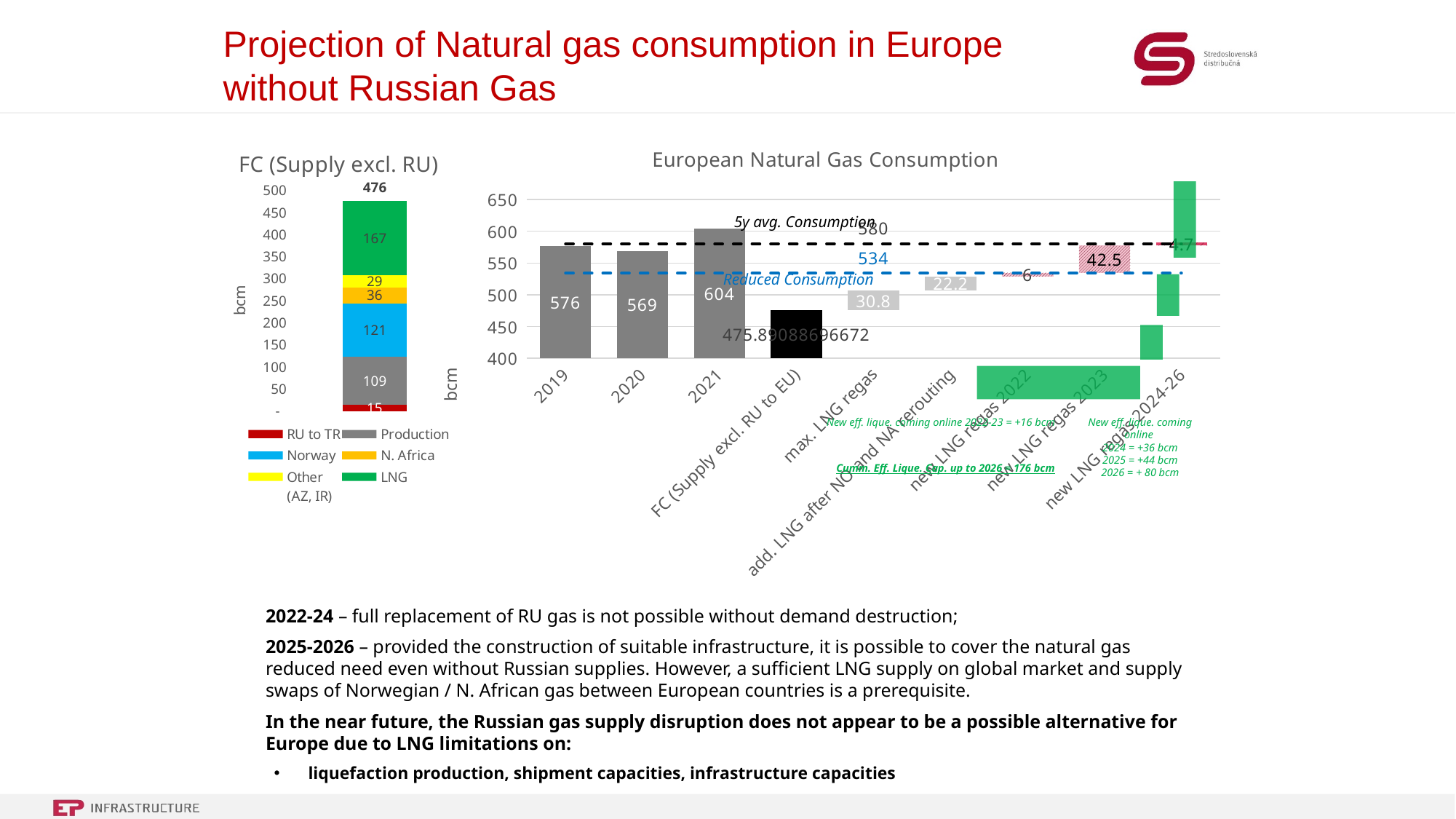
In the FC (Supply excl. RU) chart, which segment is the smallest? RU to TR In the European Natural Gas Consumption chart, which of the years 2019, 2020 and 2021 has the highest value? 2021 What kind of chart is the European Natural Gas Consumption chart? combination bar and line chart In the European Natural Gas Consumption chart, what is the value for max. LNG regas? 30.8 In the European Natural Gas Consumption chart, what is the value for 2021? 604 In the FC (Supply excl. RU) chart, what is the value of the Norway segment? 121 In the European Natural Gas Consumption chart, what value is shown for the 5y avg. Consumption line? 580 In the European Natural Gas Consumption chart, what is the difference between the 2019 and 2020 values? 7 In the FC (Supply excl. RU) chart, which segment is the largest? LNG In the FC (Supply excl. RU) chart, what is the value of the LNG segment? 167 How many series does the legend of the FC (Supply excl. RU) chart list? 6 In the FC (Supply excl. RU) chart, what is the total of the stacked bar? 476